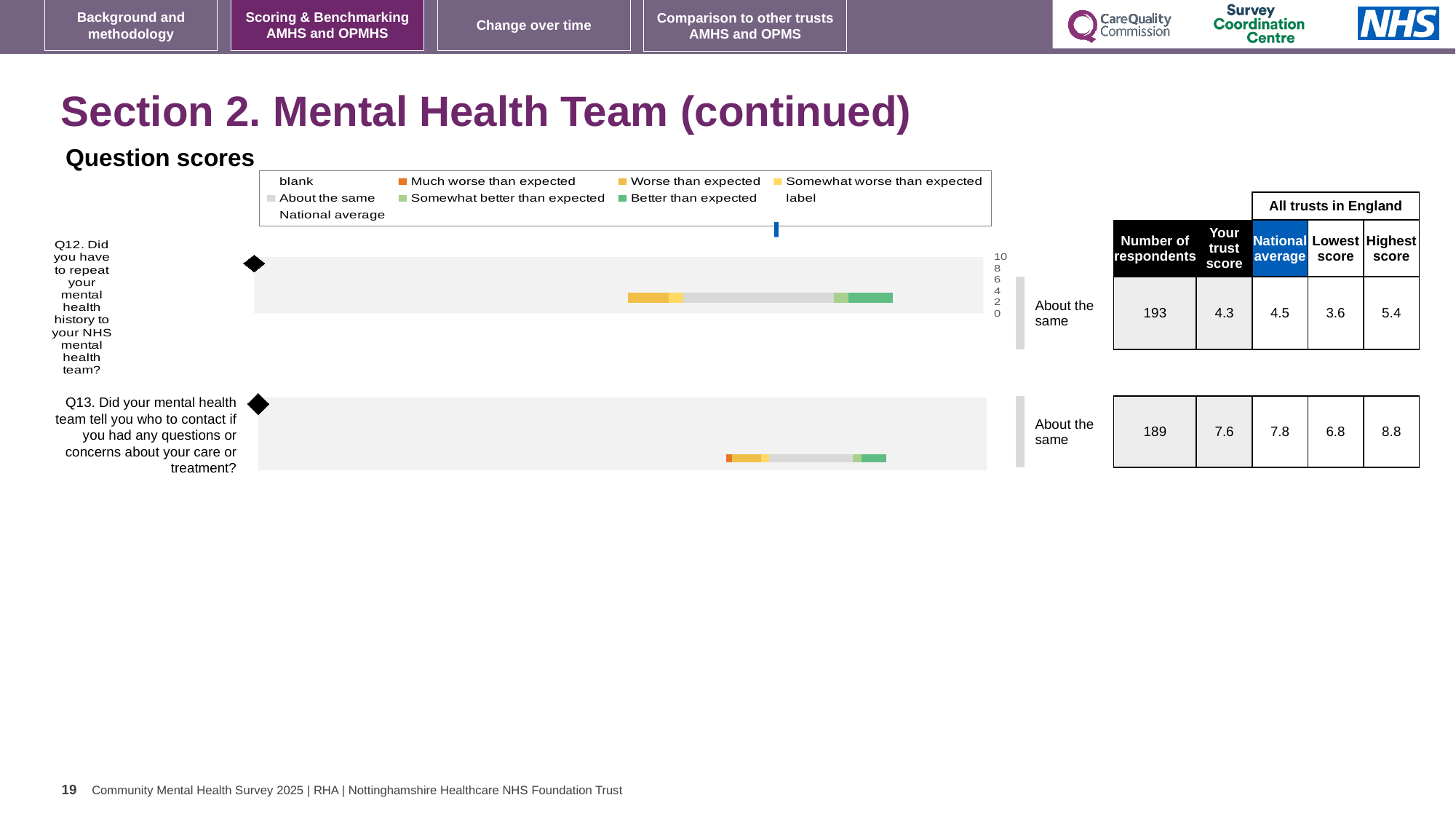
What benchmark category is shown for Q12? About the same For Q12, which is larger: your trust score or the national average? national average What kind of chart is used to show the question scores for Q12 and Q13? bar chart Which question has the higher 'Your trust score', Q12 or Q13? Q13 What is the lowest score among all trusts in England for Q13? 6.8 What is the highest score among all trusts in England for Q13? 8.8 How many respondents answered Q12? 193 How many questions are plotted in the question scores chart? 2 What is the 'Your trust score' value for Q12? 4.3 What is the difference between the highest and lowest scores for Q13? 2.0 What is the national average score for Q13? 7.8 What colour represents 'Much worse than expected' in the legend? orange